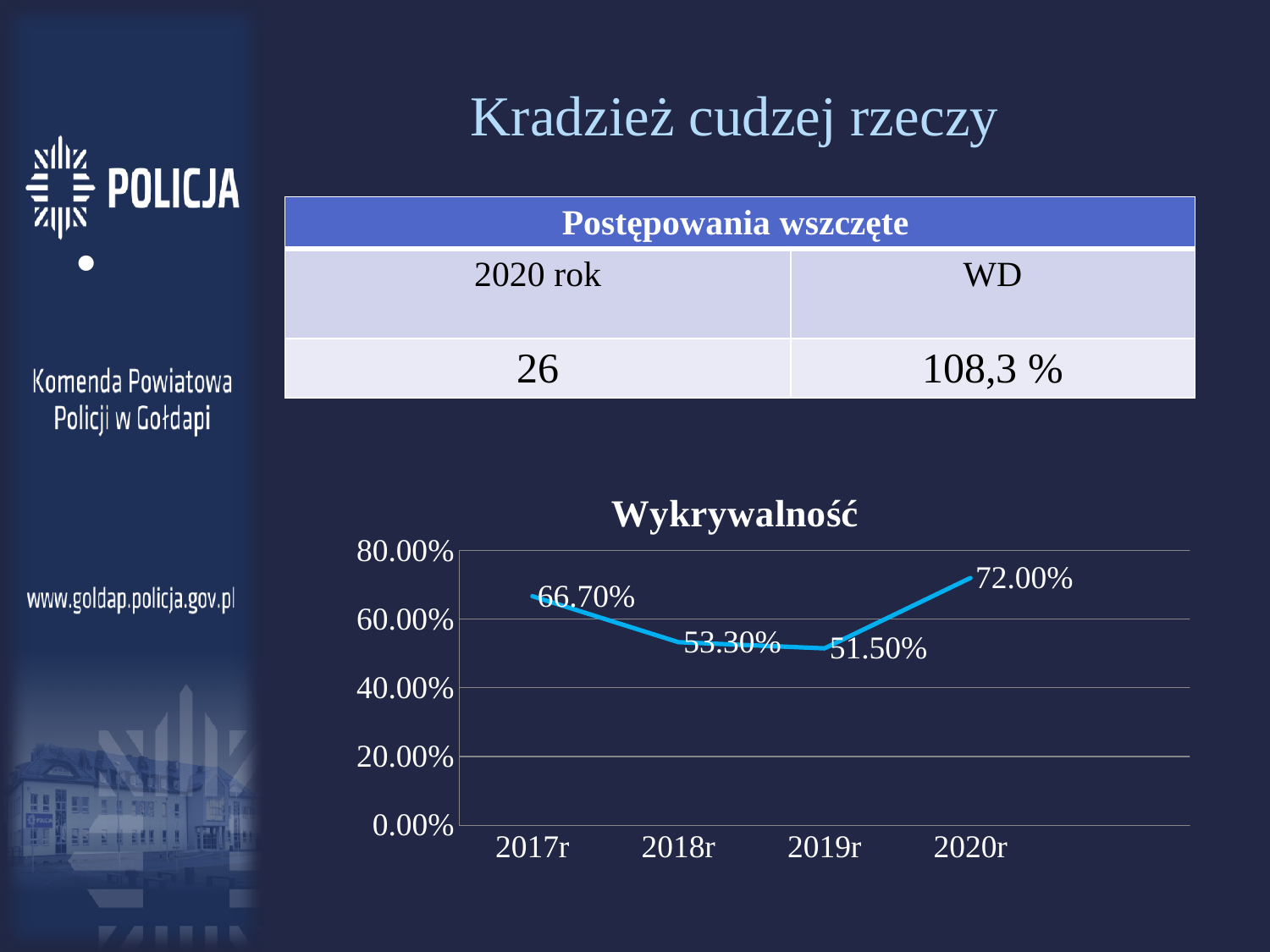
Is the value for 2019r in the Wykrywalność chart greater or less than 60.00%? less How many years are plotted in the Wykrywalność chart? 4 What kind of chart is the Wykrywalność chart? line chart Which year has the lowest value in the Wykrywalność chart? 2019r What is the title of the chart on the slide? Wykrywalność What is the value for 2020r in the Wykrywalność chart? 72.00% What is the value for 2017r in the Wykrywalność chart? 66.70% Which year has the highest value in the Wykrywalność chart? 2020r Which is larger in the Wykrywalność chart, the value for 2017r or the value for 2018r? 2017r What is the difference between the 2020r and 2017r values in the Wykrywalność chart? 5.30% What is the value for 2018r in the Wykrywalność chart? 53.30% What is the value for 2019r in the Wykrywalność chart? 51.50%